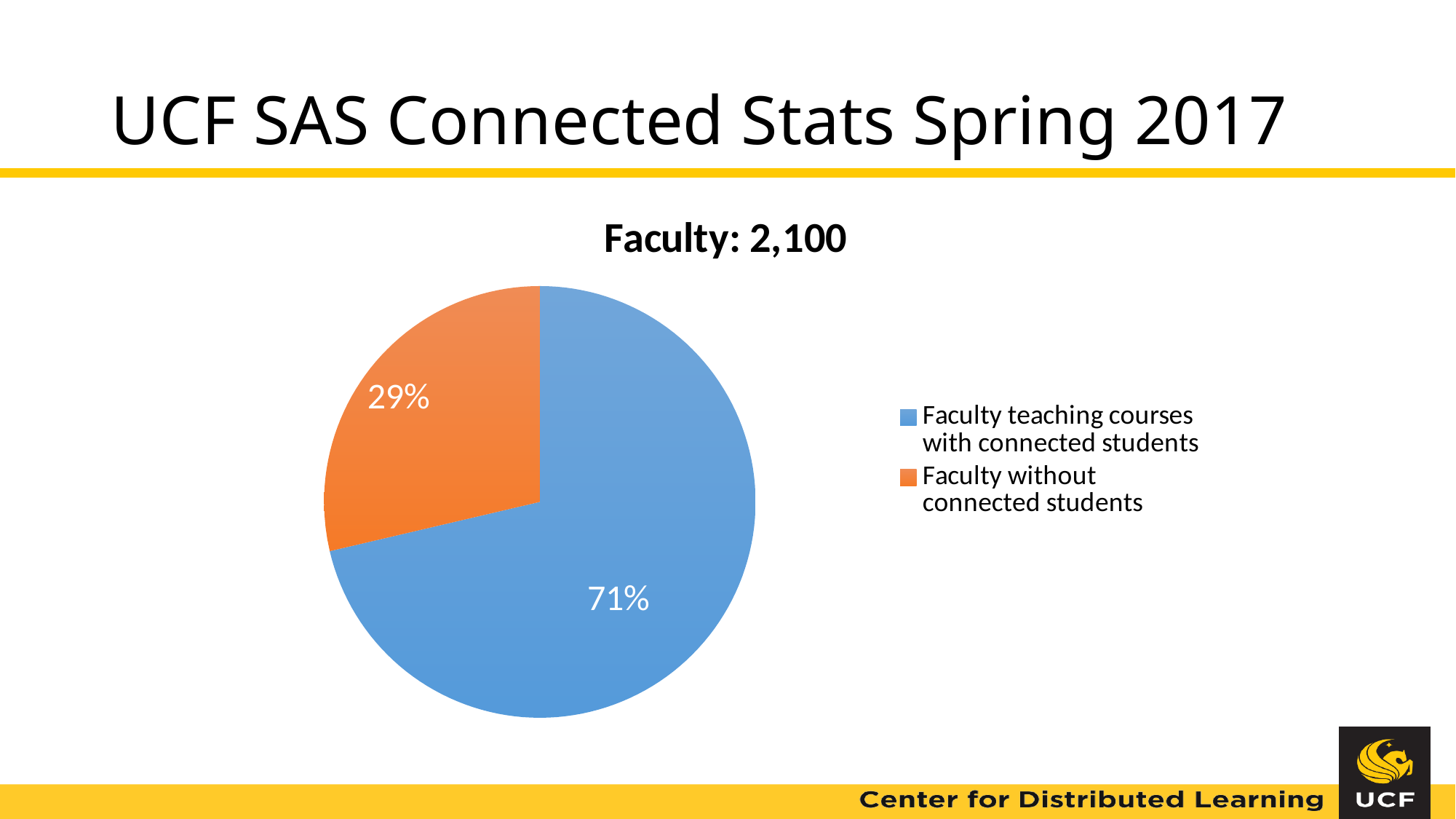
What share of the pie is 'Faculty without connected students'? 29% Which is larger: the slice for 'Faculty teaching courses with connected students' or the slice for 'Faculty without connected students'? Faculty teaching courses with connected students How many slices does the pie chart have? 2 What colour is the slice for 'Faculty without connected students'? orange How many entries does the legend list? 2 What is the difference in percentage points between the 'Faculty teaching courses with connected students' slice and the 'Faculty without connected students' slice? 42 What share of the pie is 'Faculty teaching courses with connected students'? 71% What kind of chart is shown on the slide? pie chart What is the chart's title? Faculty: 2,100 Which category has the largest slice of the pie? Faculty teaching courses with connected students Which category has the smallest slice of the pie? Faculty without connected students